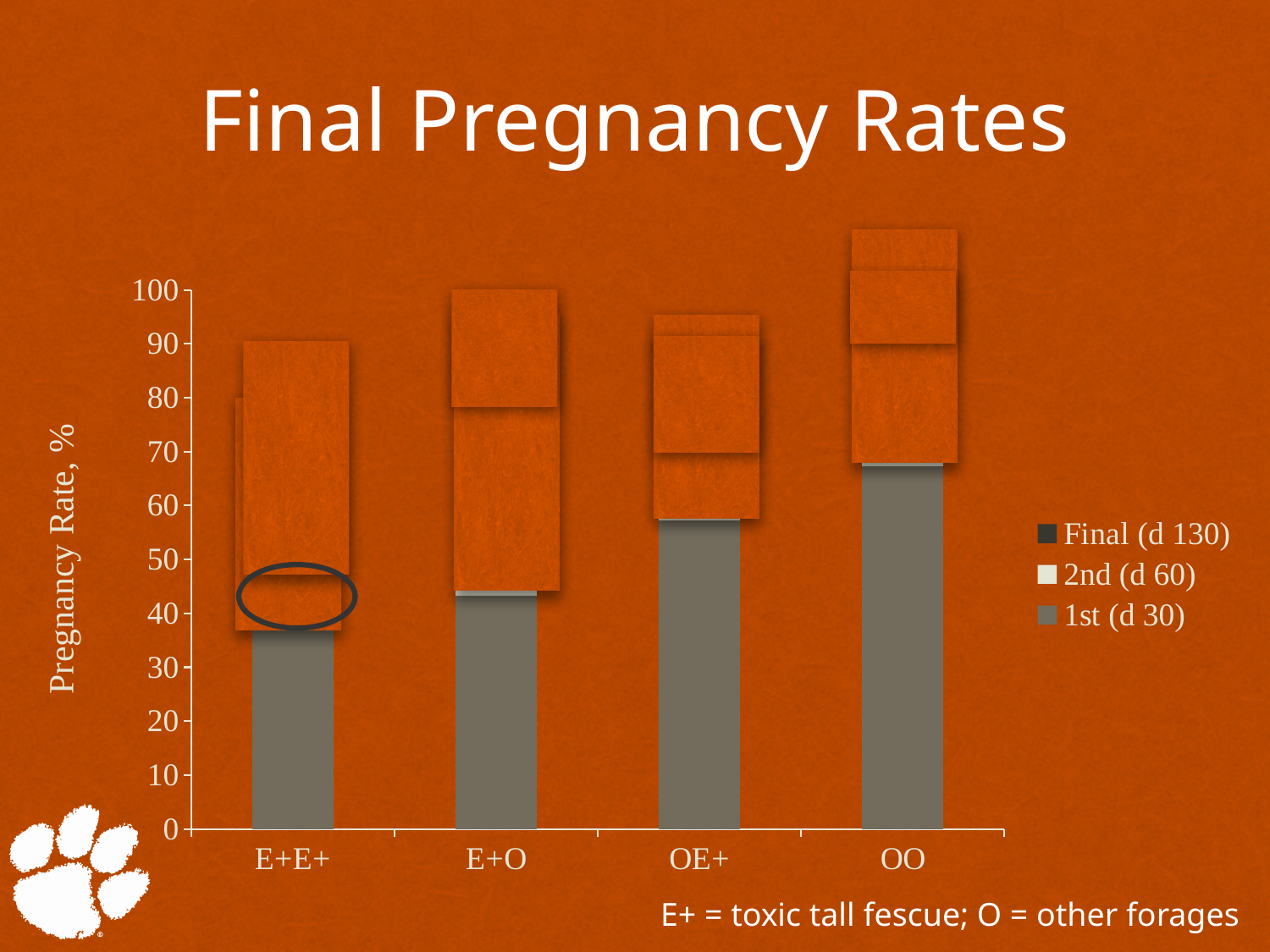
What is the label on the y axis of the chart? Pregnancy Rate, % What kind of chart is shown on the slide? Stacked bar chart For the 1st (d 30) series, which is larger: OE+ or E+O? OE+ What is the title of the chart? Final Pregnancy Rates Is the 1st (d 30) value for OO greater or less than 60? greater How many categories are shown on the x axis of the chart? 4 Is the 1st (d 30) value for OE+ greater or less than 50? greater How many series does the legend list? 3 Which category has the lowest value for the 1st (d 30) series? E+E+ Which category has the highest value for the 1st (d 30) series? OO Do the 1st (d 30) values rise or fall moving from E+E+ to OO along the x axis? rise